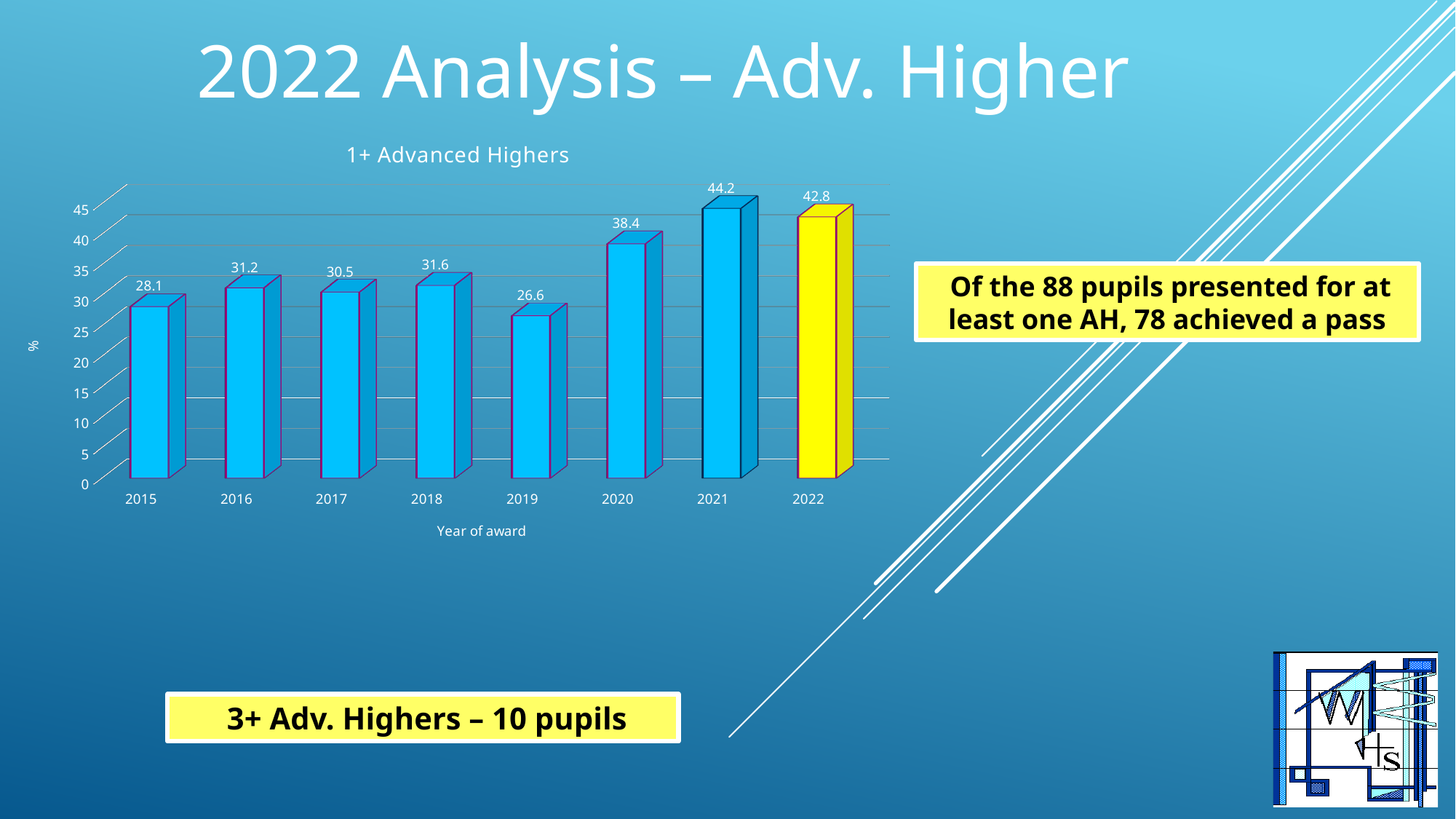
What kind of chart is shown? bar chart Which is larger, the value for 2016 or the value for 2017? 2016 What is the difference between the values for 2021 and 2022? 1.4 Which year has the lowest value? 2019 What is the difference between the values for 2020 and 2019? 11.8 What is the title of the chart? 1+ Advanced Highers What is the value for 2022? 42.8 What is the value for 2019? 26.6 Which year has the highest value? 2021 What is the value for 2015? 28.1 Is the value for 2020 greater or less than 35? greater How many years are shown on the x axis? 8